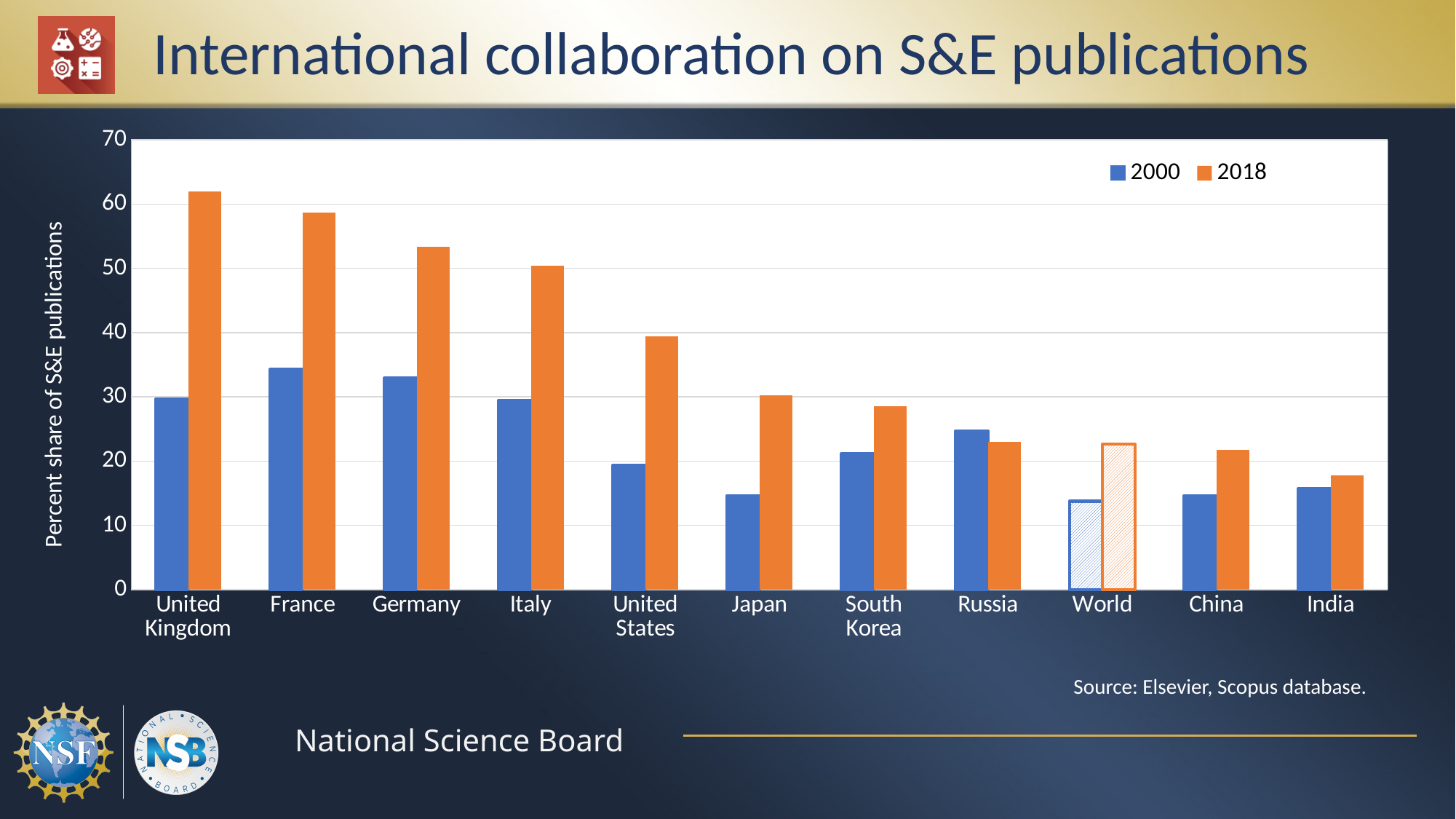
Which has the larger 2018 value, the United Kingdom or France? United Kingdom For Russia, which year has the larger value, 2000 or 2018? 2000 Is the 2000 value for France greater or less than 30? greater Which country has the lowest 2018 value in the chart? India How many countries/regions are shown on the x axis of the chart? 11 How many series does the chart's legend list? 2 Which country has the highest 2018 value in the chart? United Kingdom Is the 2000 value for Japan greater or less than 20? less What kind of chart is shown on the slide? bar chart Is the 2018 value for the United States greater or less than 40? less What is the label on the chart's vertical axis? Percent share of S&E publications